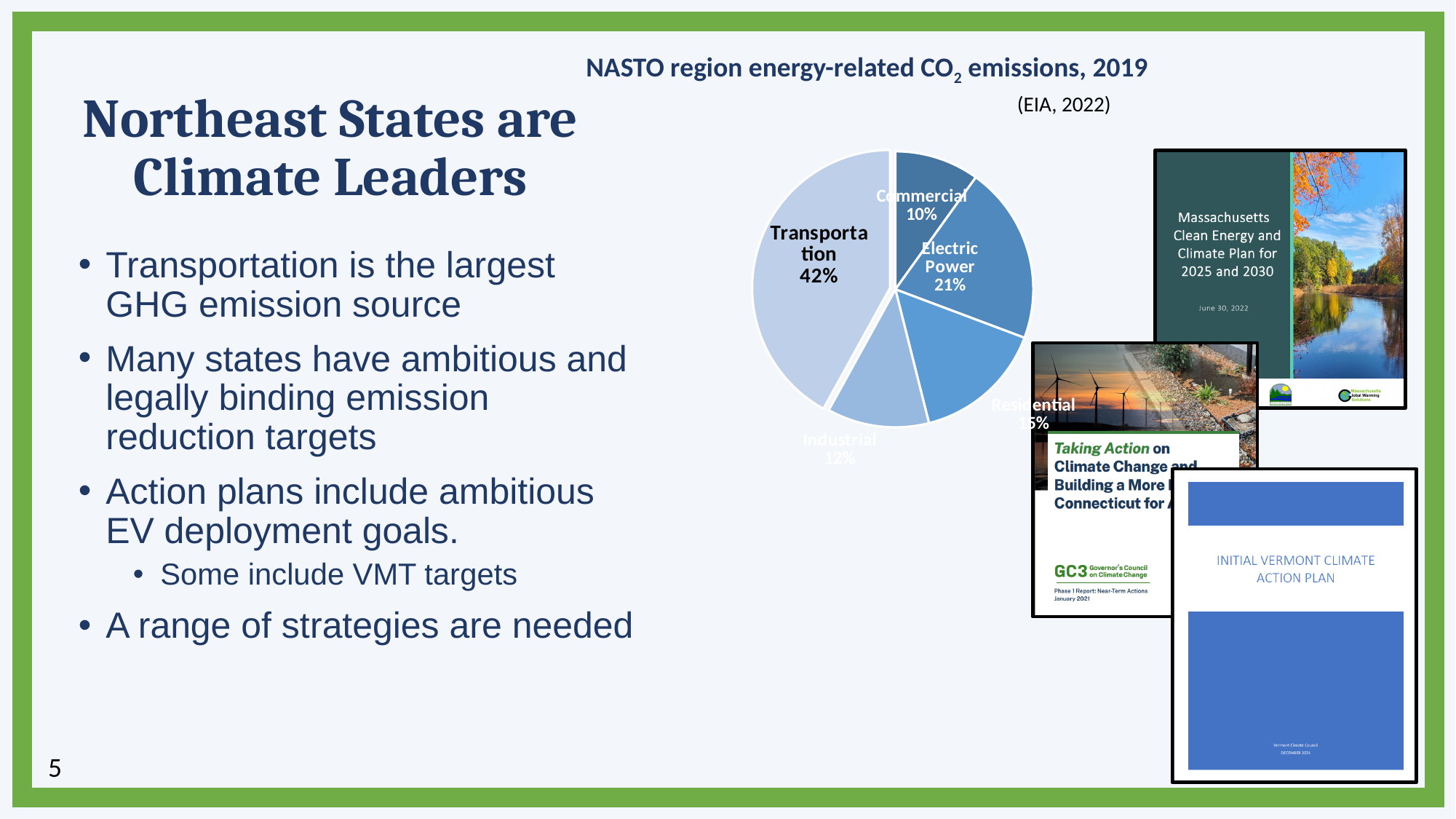
How many slices does the pie chart have? 5 Which is larger, the Residential share or the Industrial share? Residential What kind of chart is shown on the slide? Pie chart What share of emissions does Residential account for? 15% What share of emissions does Electric Power account for? 21% What share of emissions does Industrial account for? 12% Which sector has the largest share of emissions? Transportation What share of emissions does Commercial account for? 10% What share of emissions does Transportation account for? 42% Which sector has the smallest share of emissions? Commercial What is the difference in percentage points between Transportation and Electric Power? 21 What is the title of the chart? NASTO region energy-related CO2 emissions, 2019